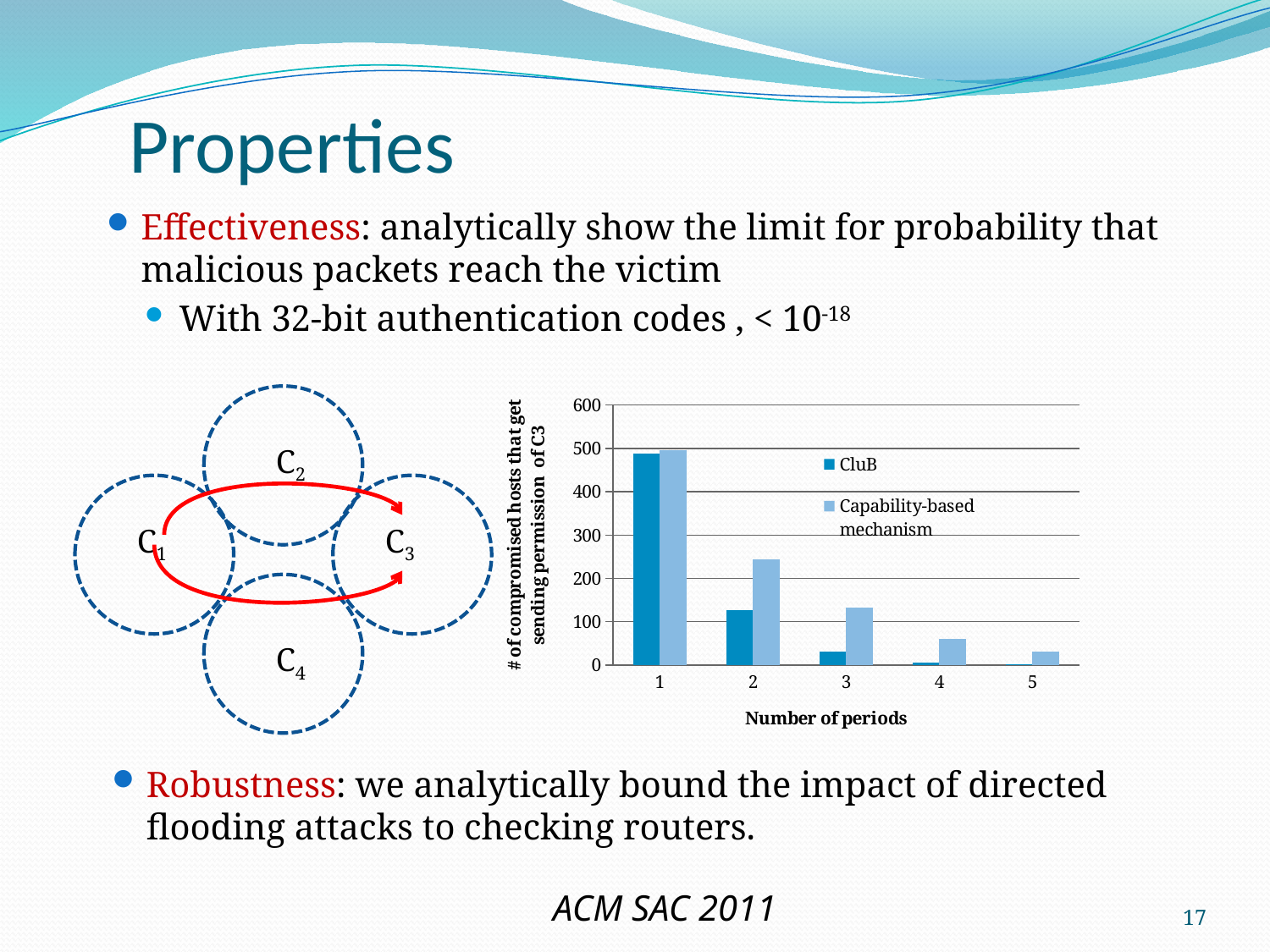
How many series does the chart legend list? 2 At period 2, which series has the larger value, CluB or Capability-based mechanism? Capability-based mechanism How many periods are shown along the x axis of the chart? 5 What is the x-axis title of the chart? Number of periods For which number of periods is the Capability-based mechanism value lowest? 5 Is the Capability-based mechanism value for period 2 greater or less than 300? less For which number of periods is the CluB value highest? 1 What kind of chart is shown on the slide? bar chart Is the CluB value for period 1 greater or less than 400? greater Is the CluB value for period 2 greater or less than 200? less What are the two series named in the chart legend? CluB and Capability-based mechanism